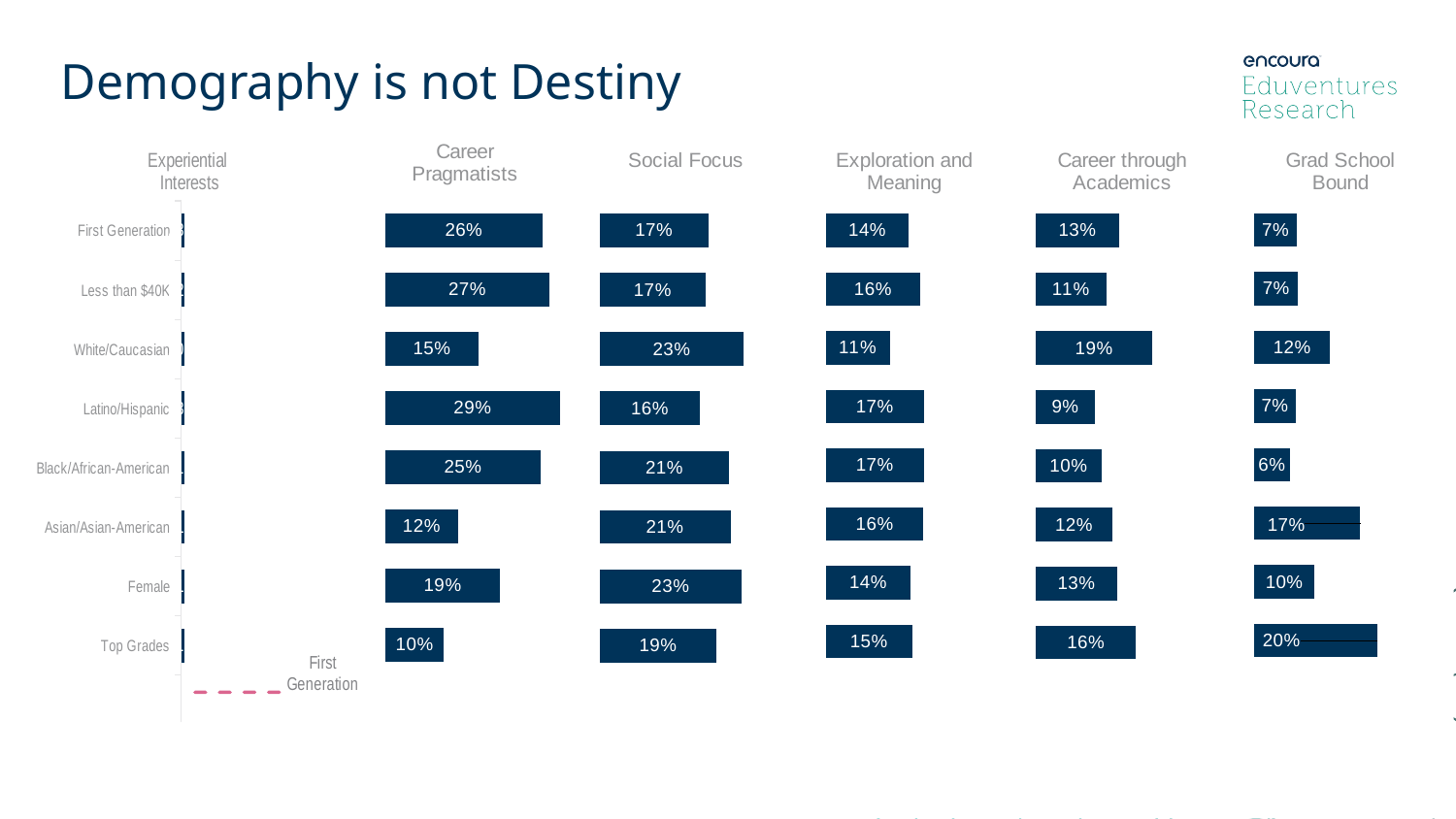
In the Career Pragmatists chart, which category has the highest value? Latino/Hispanic In the Career through Academics chart, what is the value for White/Caucasian? 19% In the Career Pragmatists chart, what is the value for Latino/Hispanic? 29% In the Career through Academics chart, which category has the lowest value? Latino/Hispanic In the Career Pragmatists chart, which category has the lowest value? Top Grades In the Exploration and Meaning chart, what is the difference between the values for Latino/Hispanic and White/Caucasian? 6% What type of chart is used on this slide? Bar chart In the Grad School Bound chart, which category has the lowest value? Black/African-American In the Social Focus chart, what is the value for Black/African-American? 21% How many categories are listed on the vertical axis of the charts? 8 In the Grad School Bound chart, what is the value for Top Grades? 20% In the Social Focus chart, which is larger: the value for Female or the value for Top Grades? Female